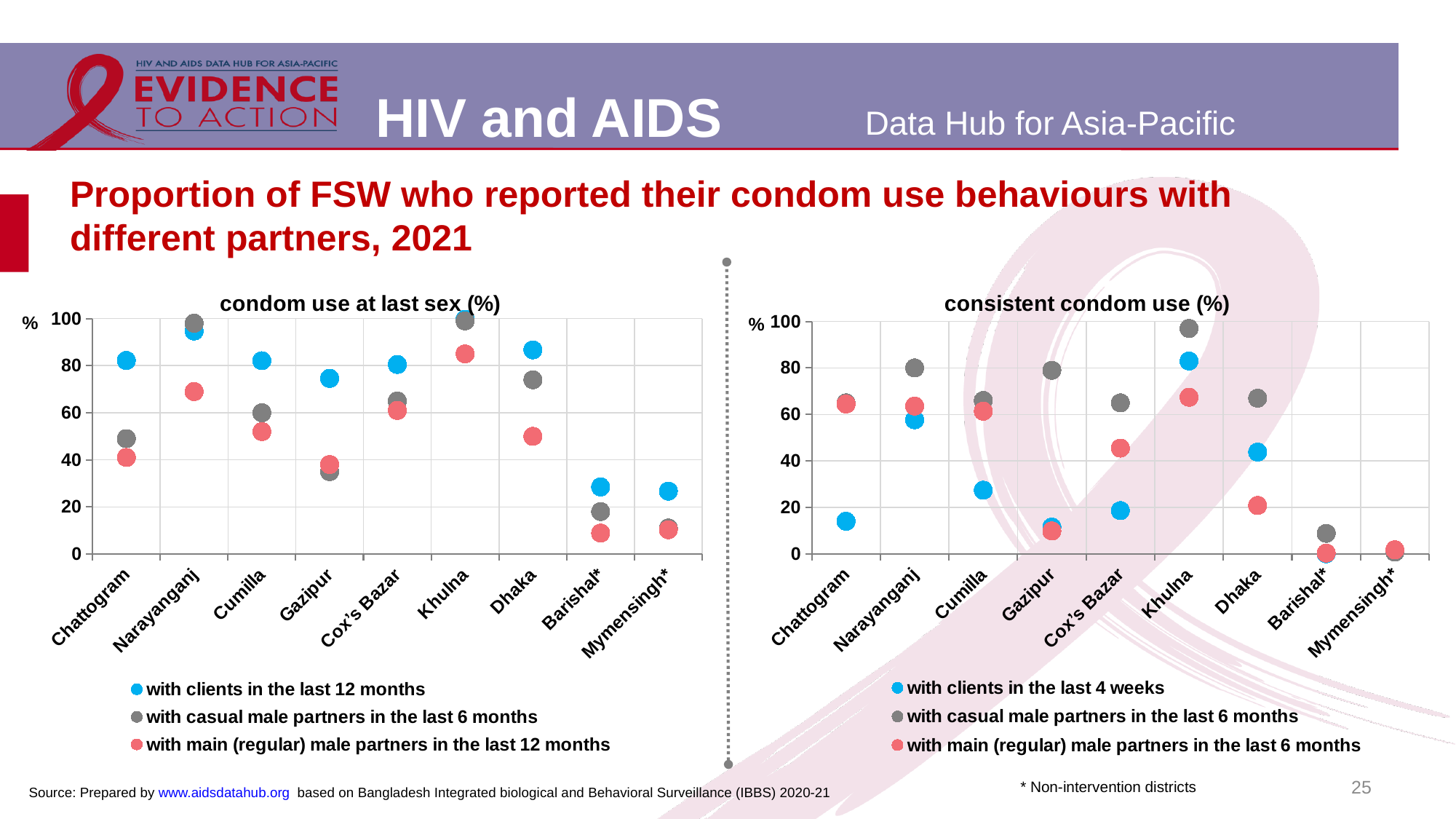
How many districts are shown on the x axis of the 'condom use at last sex (%)' chart? 9 In the 'consistent condom use (%)' chart, for Dhaka, which is larger: the value with casual male partners in the last 6 months or with main (regular) male partners in the last 6 months? with casual male partners in the last 6 months In the 'condom use at last sex (%)' chart, is the value for Khulna with casual male partners in the last 6 months greater or less than 80? greater In the 'consistent condom use (%)' chart, which district has the lowest value with casual male partners in the last 6 months? Mymensingh* In the 'consistent condom use (%)' chart, which district has the highest value with clients in the last 4 weeks? Khulna What kind of chart is the left chart titled 'condom use at last sex (%)'? scatter (dot) chart In the 'consistent condom use (%)' chart, is the value for Chattogram with clients in the last 4 weeks greater or less than 20? less In the 'condom use at last sex (%)' chart, for Chattogram, which is larger: the value with clients in the last 12 months or with main (regular) male partners in the last 12 months? with clients in the last 12 months In the 'condom use at last sex (%)' chart, which district has the highest value with main (regular) male partners in the last 12 months? Khulna In the 'condom use at last sex (%)' chart, is the value for Barishal* with clients in the last 12 months greater or less than 40? less How many series does the legend of the 'consistent condom use (%)' chart list? 3